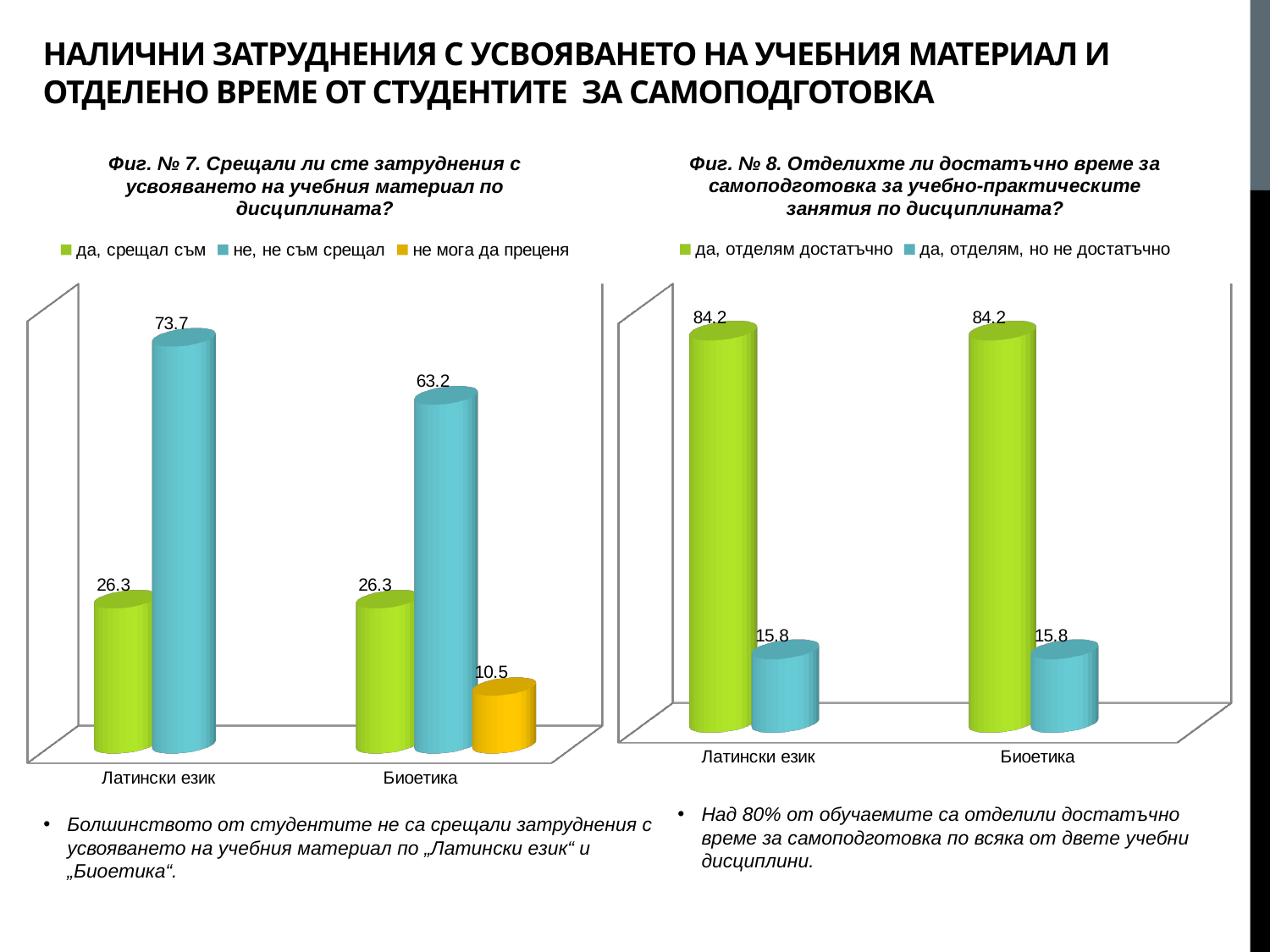
In the left chart (Фиг. № 7), what is the value for "не мога да преценя" for Биоетика? 10.5 In the left chart (Фиг. № 7), what is the difference between the "не, не съм срещал" values for Латински език and Биоетика? 10.5 In the right chart (Фиг. № 8), what is the value for "да, отделям, но не достатъчно" for Латински език? 15.8 In the left chart (Фиг. № 7), how many series does the legend list? 3 In the left chart (Фиг. № 7), what is the value for "не, не съм срещал" for Латински език? 73.7 In the left chart (Фиг. № 7), which category has the higher value for "не, не съм срещал"? Латински език In the left chart (Фиг. № 7), how many categories are shown on the x axis? 2 In the right chart (Фиг. № 8), what is the value for "да, отделям достатъчно" for Биоетика? 84.2 In the right chart (Фиг. № 8), what is the difference between the two values for Латински език? 68.4 In the right chart (Фиг. № 8), how many series does the legend list? 2 What kind of chart is the right chart (Фиг. № 8)? Bar chart In the left chart (Фиг. № 7), what is the value for "да, срещал съм" for Биоетика? 26.3